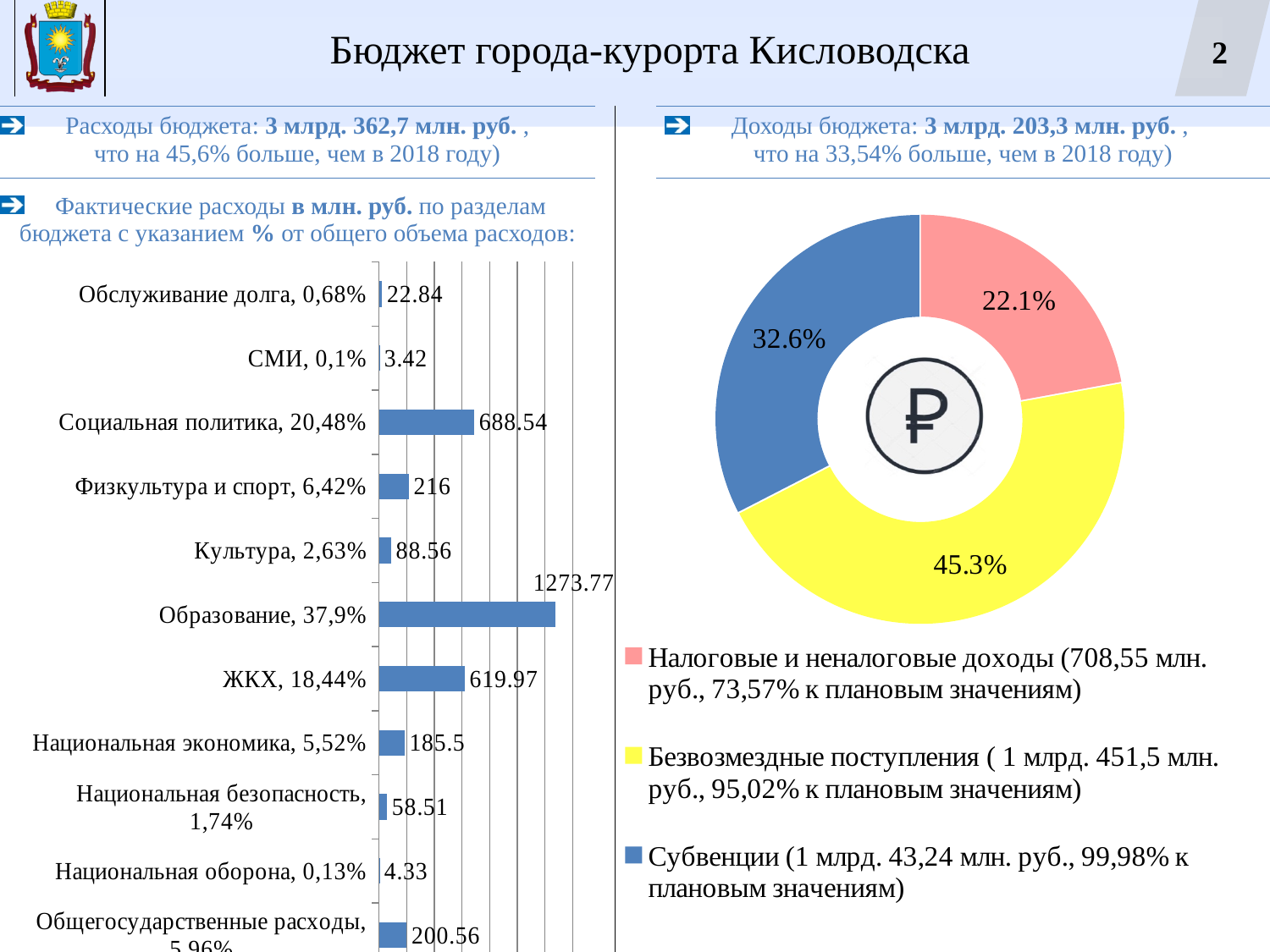
On the right pie chart, what share is shown for Субвенции? 32.6% What type of chart is shown on the left side of the slide? Bar chart On the left bar chart, which category has the highest value? Образование On the left bar chart, what is the value for Образование? 1273.77 On the left bar chart, what is the value for ЖКХ? 619.97 On the right pie chart, which slice is the smallest? Налоговые и неналоговые доходы On the left bar chart, what is the difference between the values for Социальная политика and ЖКХ? 68.57 How many entries does the legend of the right pie chart list? 3 On the left bar chart, which is larger: the value for Физкультура и спорт or the value for Национальная экономика? Физкультура и спорт On the right pie chart, what share is shown for Безвозмездные поступления? 45.3% How many categories are shown on the left bar chart? 11 On the left bar chart, which category has the lowest value? СМИ